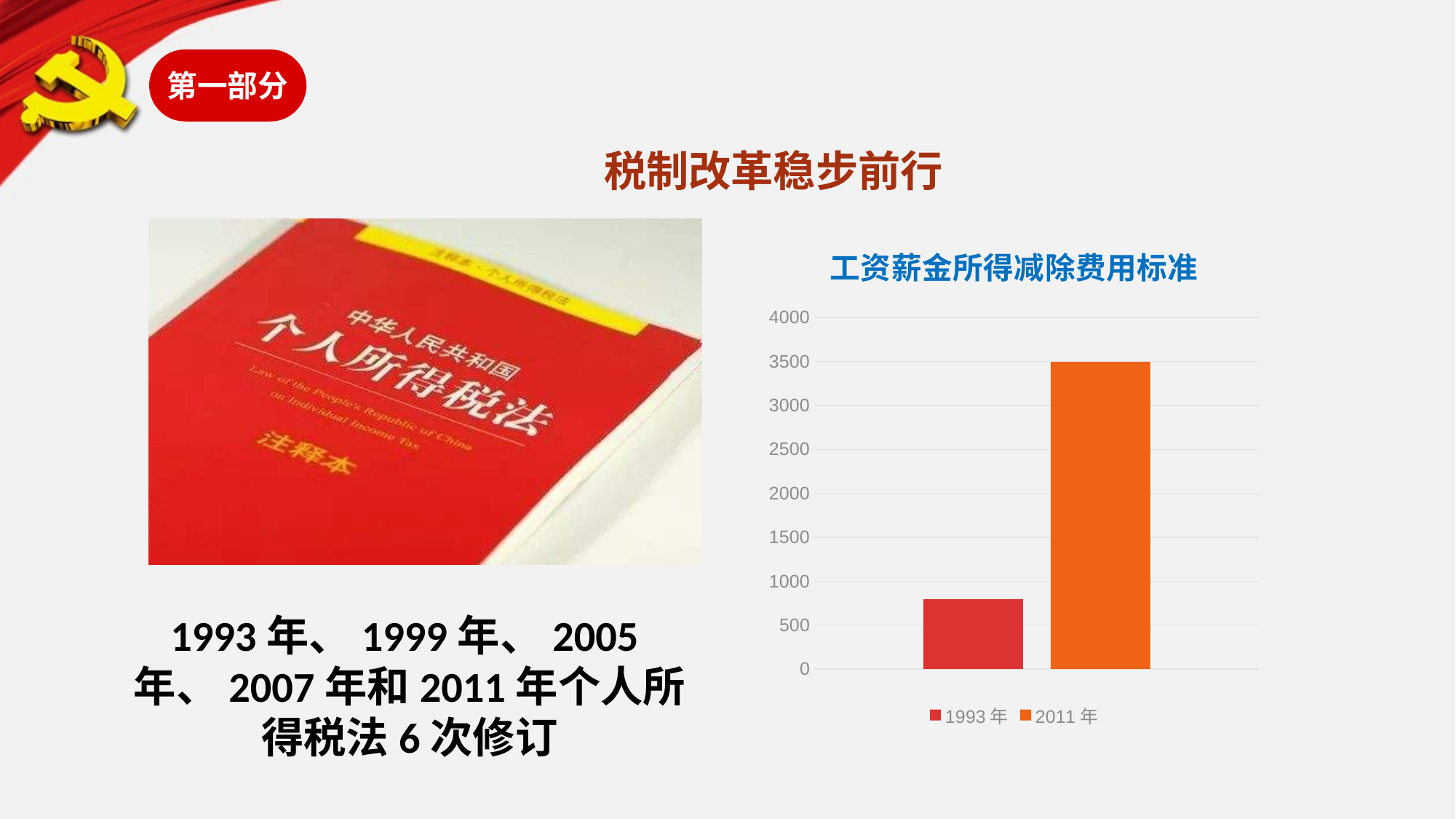
How many series does the chart legend list? 2 Which is larger, the value for 1993 年 or the value for 2011 年? 2011 年 What colour is the bar for 2011 年? orange Is the value for 2011 年 greater or less than 3000? greater Which series has the highest value in the chart? 2011 年 What kind of chart is shown on the slide? bar chart Is the value for 1993 年 greater or less than 1000? less Is the value for 1993 年 greater or less than 500? greater Which series has the lowest value in the chart? 1993 年 What is the value for 2011 年 in the chart? 3500 What is the title of the chart? 工资薪金所得减除费用标准 How many bars are plotted in the chart? 2